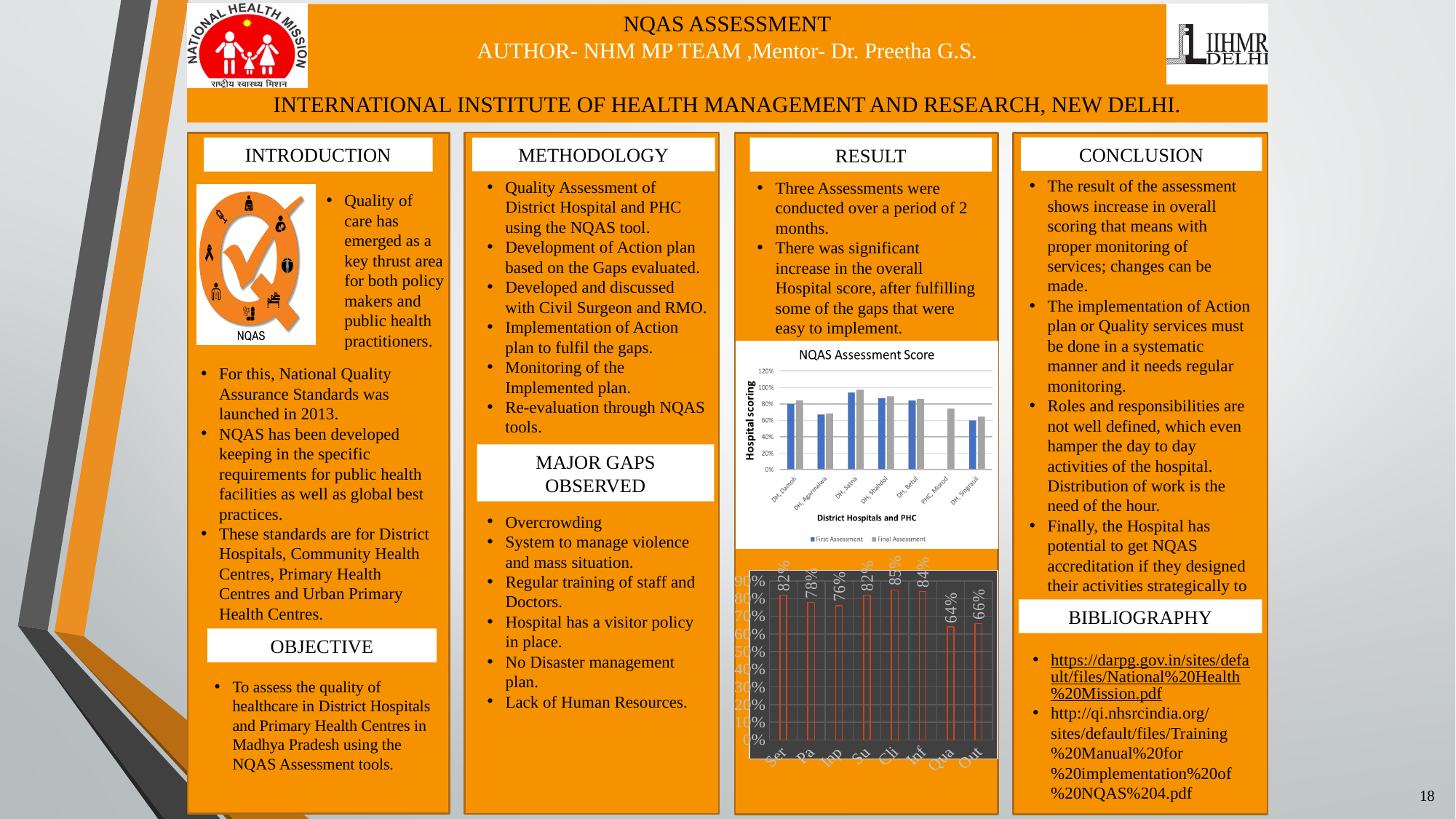
In the 'NQAS Assessment Score' chart, is the First Assessment value for DH, Satna greater or less than 80%? greater What type of chart is the 'NQAS Assessment Score' chart? bar chart In the bottom chart of the RESULT column, what is the highest value shown? 85% In the 'NQAS Assessment Score' chart, what is the title of the x axis? District Hospitals and PHC In the 'NQAS Assessment Score' chart, which is larger: the Final Assessment score for DH, Satna or for DH, Singrauli? DH, Satna In the 'NQAS Assessment Score' chart, is the Final Assessment value for PHC, Misrod greater or less than 80%? less In the 'NQAS Assessment Score' chart, how many facilities are shown on the x axis? 7 In the 'NQAS Assessment Score' chart, which facility has the highest Final Assessment score? DH, Satna In the bottom chart of the RESULT column, what is the lowest value shown? 64% In the bottom chart of the RESULT column, how many bars are plotted? 8 In the 'NQAS Assessment Score' chart, how many series does the legend list? 2 In the bottom chart of the RESULT column, what is the difference between the highest value (85%) and the lowest value (64%)? 21 percentage points